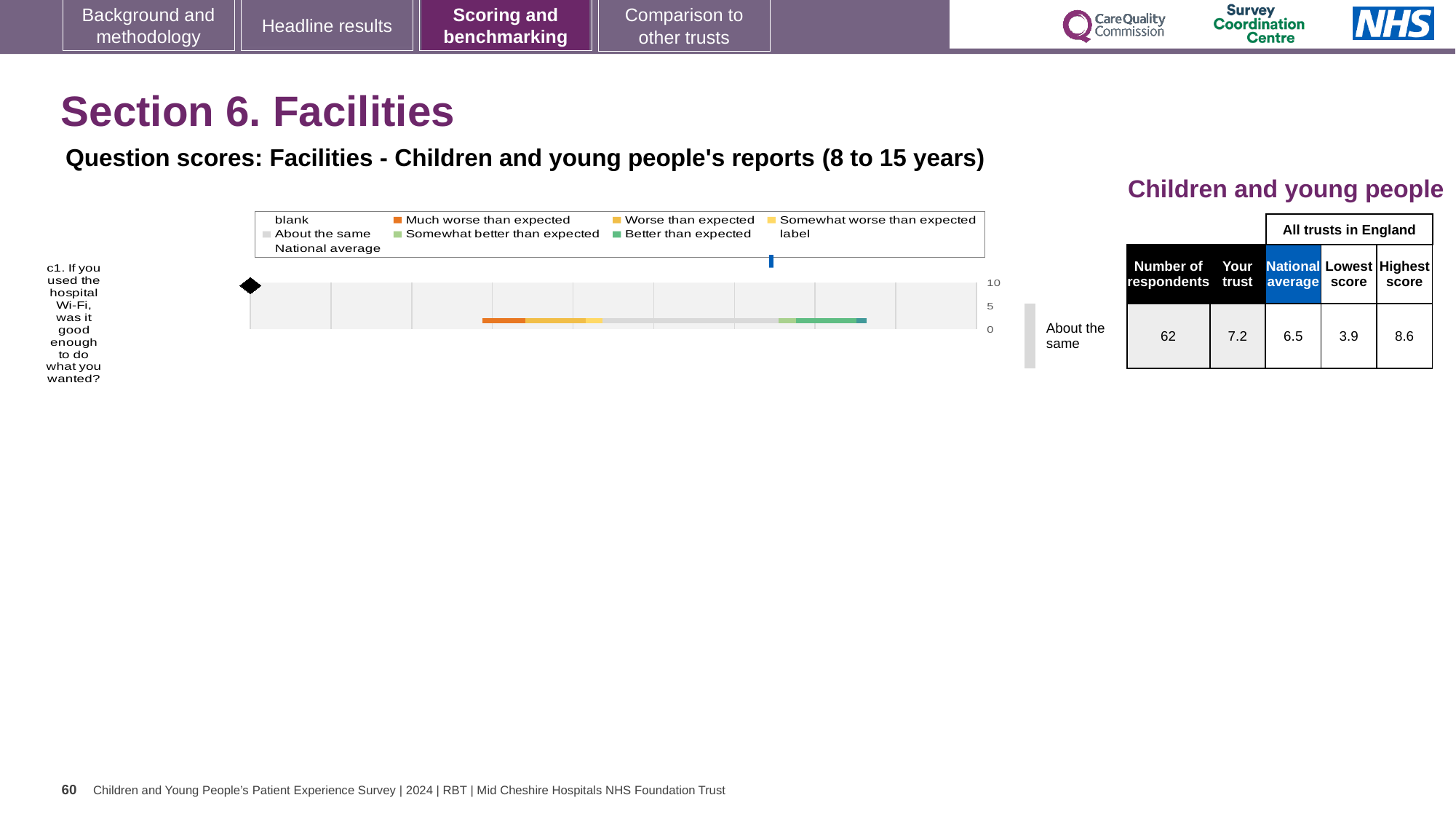
What is the lowest score among all trusts in England for question c1? 3.9 What is the difference between the trust's score and the national average for question c1? 0.7 What is the 'Your trust' score for question c1 about the hospital Wi-Fi? 7.2 How many survey questions are plotted in the chart? 1 What is the highest score among all trusts in England for question c1? 8.6 What is the difference between the highest and lowest scores among all trusts in England for question c1? 4.7 How many respondents answered question c1 about the hospital Wi-Fi? 62 Which legend entry is shown in orange? Much worse than expected Is the trust's score for question c1 higher or lower than the national average? higher What kind of chart is used to show the question score for c1? bar chart What is the national average score for question c1 about the hospital Wi-Fi? 6.5 Which benchmark category is the trust's result for question c1 placed in? About the same